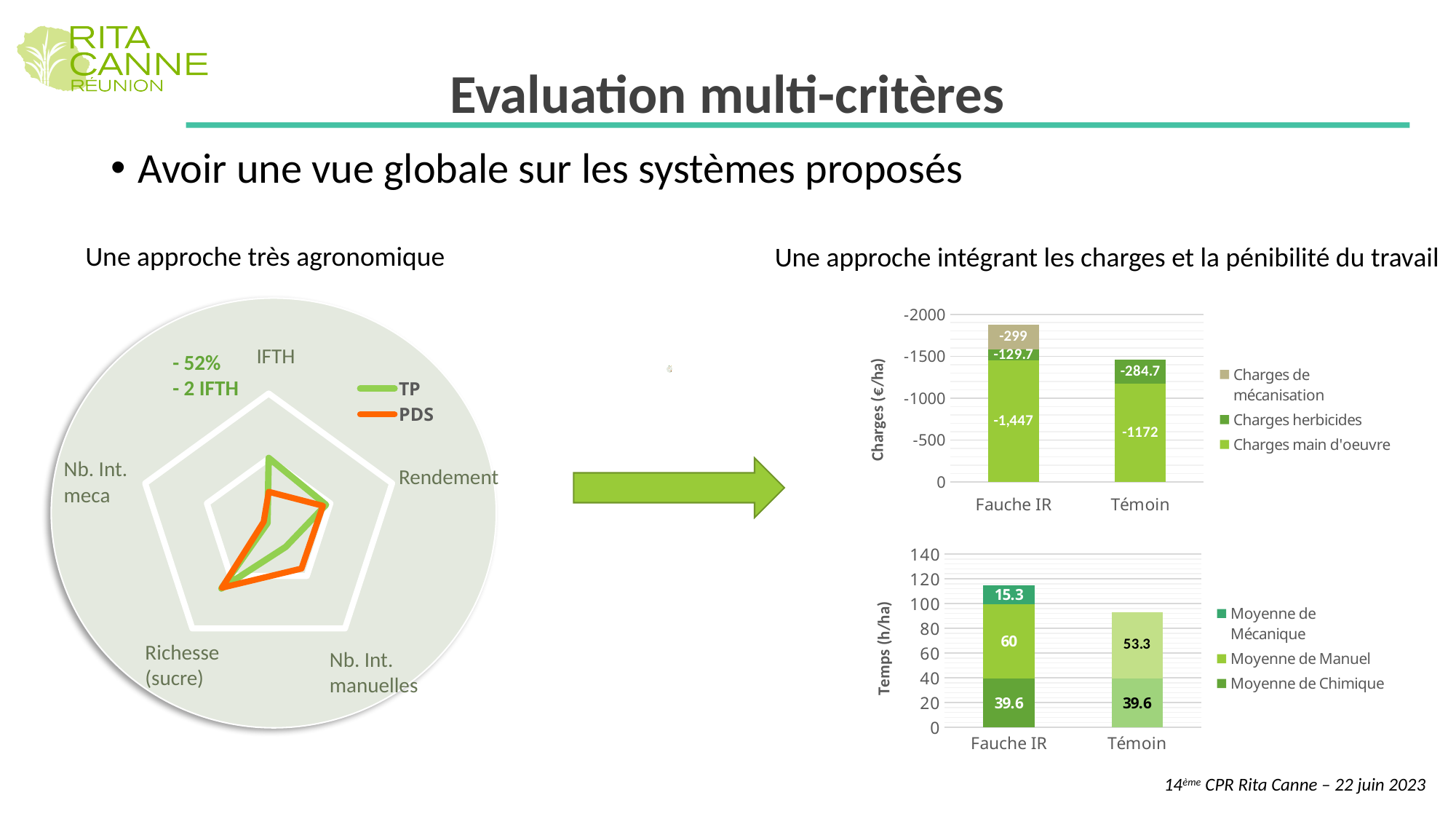
In the Charges (€/ha) chart, what is the value of Charges herbicides for Témoin? -284.7 In the Charges (€/ha) chart, what is the value of Charges main d'oeuvre for Fauche IR? -1,447 In the Temps (h/ha) chart, what kind of chart is shown? Bar chart In the radar chart on the left, how many axes (criteria) are shown? 5 In the Temps (h/ha) chart, what is the value of Moyenne de Manuel for Témoin? 53.3 In the Temps (h/ha) chart, what is the value of Moyenne de Mécanique for Fauche IR? 15.3 In the Charges (€/ha) chart, how many series does the legend list? 3 In the Temps (h/ha) chart, what is the difference between Moyenne de Manuel for Fauche IR and for Témoin? 6.7 In the Temps (h/ha) chart, which category has the larger Moyenne de Manuel value, Fauche IR or Témoin? Fauche IR In the Charges (€/ha) chart, what is the value of Charges de mécanisation for Fauche IR? -299 In the Temps (h/ha) chart, what is the total of the stacked bar for Fauche IR? 114.9 In the radar chart on the left, how many series does the legend list? 2